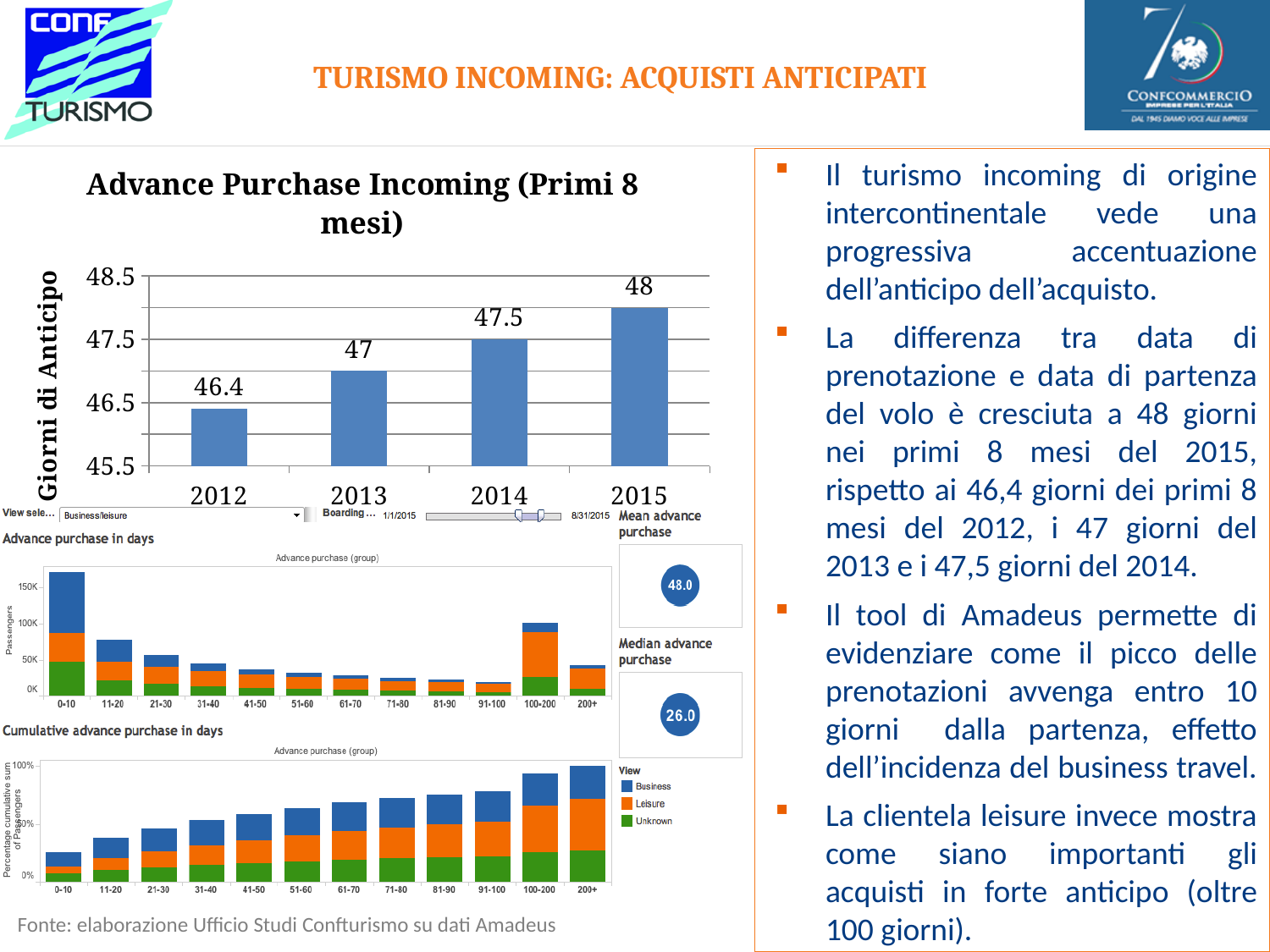
In the 'Advance Purchase Incoming (Primi 8 mesi)' chart, what is the value for 2015? 48 In the 'Advance Purchase Incoming (Primi 8 mesi)' chart, which year has the highest value? 2015 In the 'Cumulative advance purchase in days' chart at the bottom of the slide, how many series does the legend list? 3 What kind of chart is 'Advance Purchase Incoming (Primi 8 mesi)'? Bar chart In the 'Advance Purchase Incoming (Primi 8 mesi)' chart, which is larger, the value for 2013 or the value for 2014? 2014 In the 'Advance Purchase Incoming (Primi 8 mesi)' chart, what is the value for 2012? 46.4 In the 'Advance Purchase Incoming (Primi 8 mesi)' chart, how many years are shown on the x axis? 4 In the 'Advance Purchase Incoming (Primi 8 mesi)' chart, do the values rise or fall from 2012 to 2015? Rise In the 'Advance Purchase Incoming (Primi 8 mesi)' chart, what is the difference between the 2015 and 2012 values? 1.6 In the 'Advance Purchase Incoming (Primi 8 mesi)' chart, what is the value for 2014? 47.5 In the 'Advance Purchase Incoming (Primi 8 mesi)' chart, which year has the lowest value? 2012 In the 'Advance Purchase Incoming (Primi 8 mesi)' chart, what is the difference between the 2014 and 2013 values? 0.5